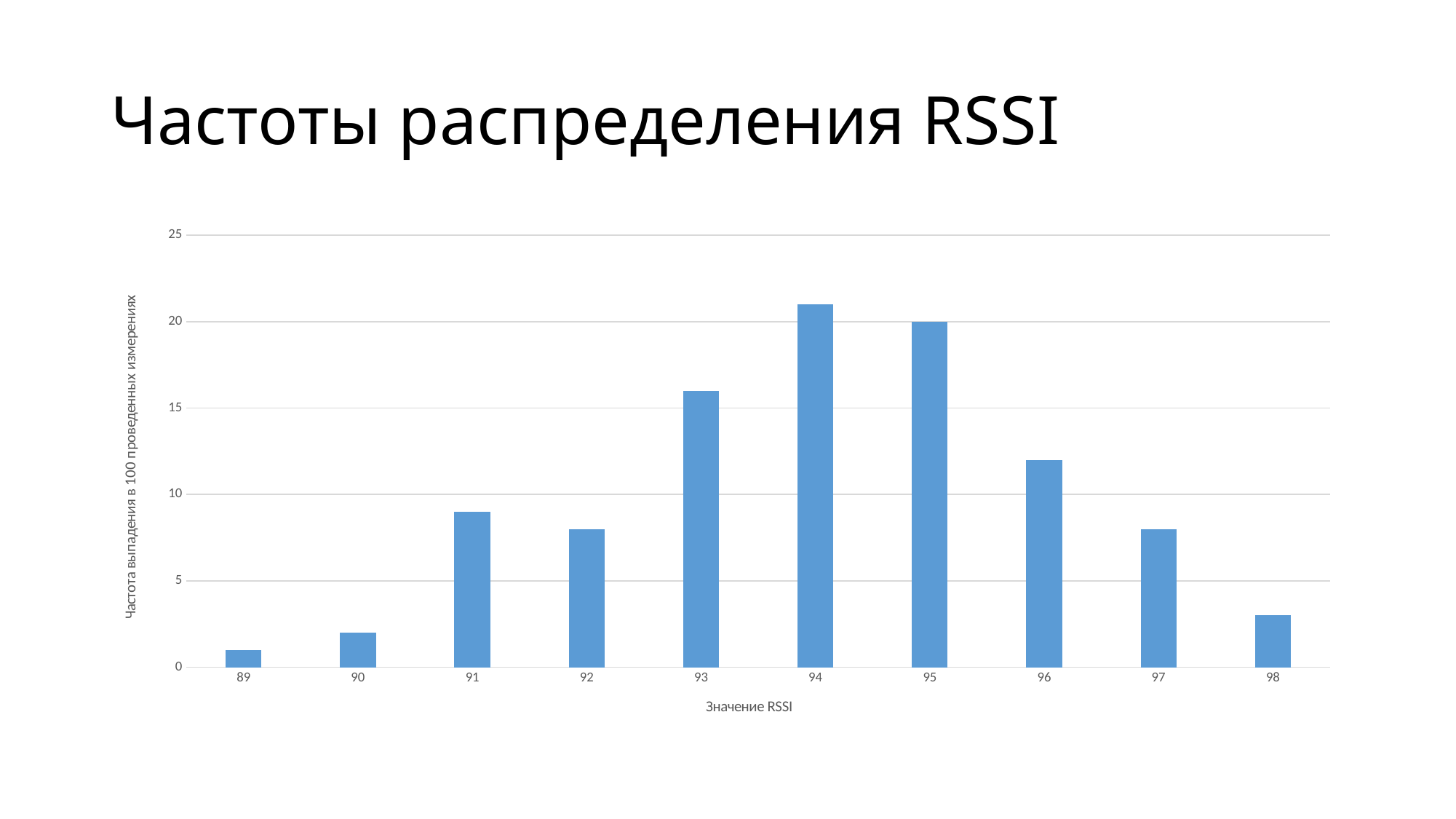
What is the title of the chart on the slide? Частоты распределения RSSI How many RSSI values (categories) are shown on the x axis? 10 Is the frequency for RSSI value 93 greater or less than 15? greater Which RSSI value has the lowest frequency? 89 Which RSSI value has the highest frequency? 94 What is the frequency for RSSI value 95? 20 Is the frequency for RSSI value 96 greater or less than 10? greater Which has a higher frequency, RSSI value 93 or RSSI value 96? 93 Is the frequency for RSSI value 98 greater or less than 5? less Do the frequencies rise or fall from RSSI value 95 to RSSI value 98? fall What kind of chart is shown on the slide? bar chart